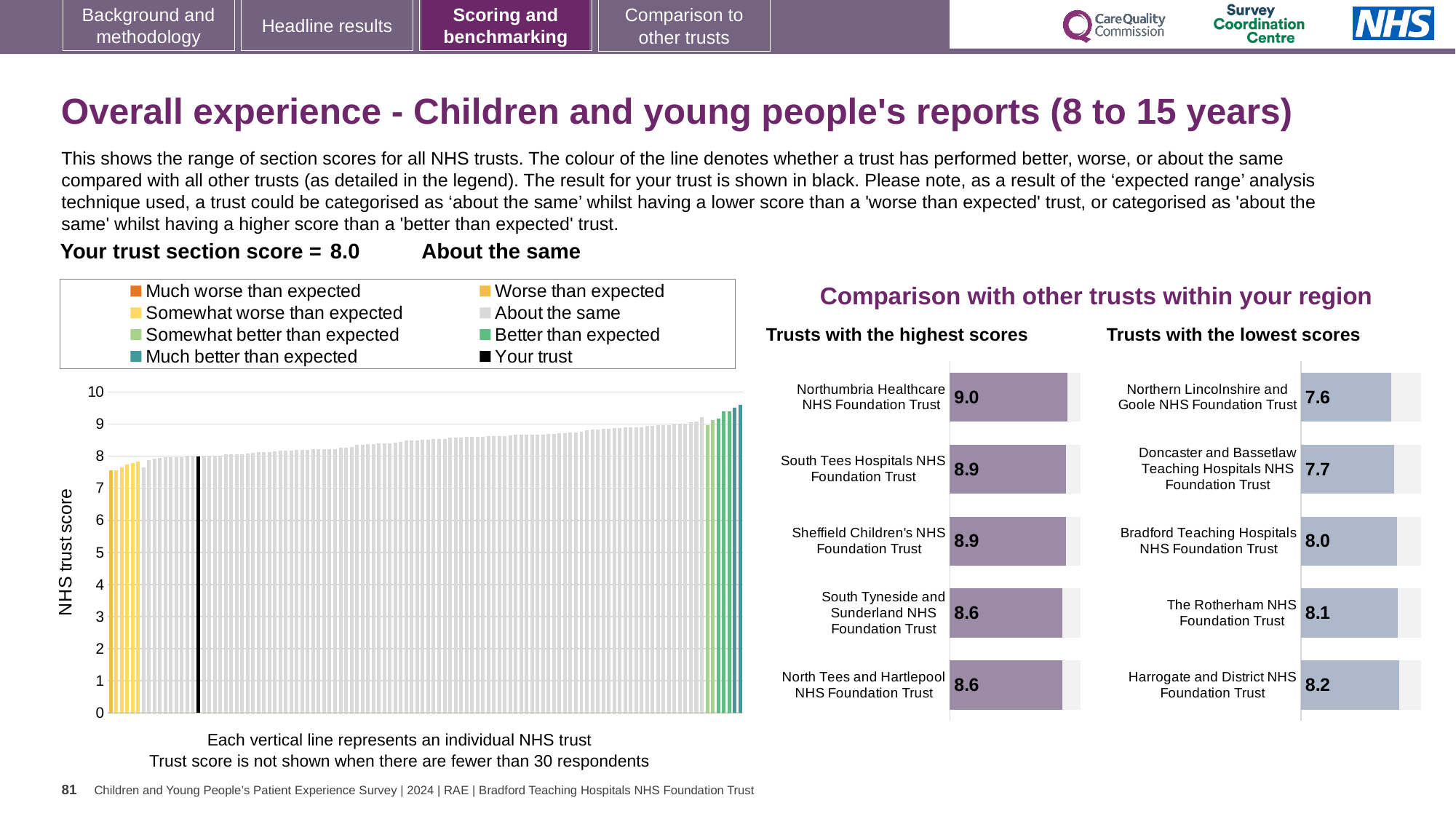
In the 'Trusts with the highest scores' chart, what is the score for Northumbria Healthcare NHS Foundation Trust? 9.0 In the 'Trusts with the lowest scores' chart, which has the larger score: The Rotherham NHS Foundation Trust or Doncaster and Bassetlaw Teaching Hospitals NHS Foundation Trust? The Rotherham NHS Foundation Trust In the 'Trusts with the highest scores' chart, which trust has the highest score? Northumbria Healthcare NHS Foundation Trust In the 'Trusts with the highest scores' chart, how many trusts are shown? 5 In the large chart on the left, is the value of the tallest bar greater or less than 9? greater In the 'Trusts with the lowest scores' chart, which trust has the lowest score? Northern Lincolnshire and Goole NHS Foundation Trust In the large chart on the left, is the value of the shortest bar greater or less than 8? less What kind of chart is the large chart on the left with the y axis labelled 'NHS trust score'? bar chart In the 'Trusts with the highest scores' chart, what is the difference between the scores of Northumbria Healthcare NHS Foundation Trust and South Tyneside and Sunderland NHS Foundation Trust? 0.4 In the large chart on the left, do the trust scores rise or fall from left to right along the x axis? rise How many entries does the legend above the large chart on the left list? 8 In the 'Trusts with the lowest scores' chart, what is the score for Bradford Teaching Hospitals NHS Foundation Trust? 8.0